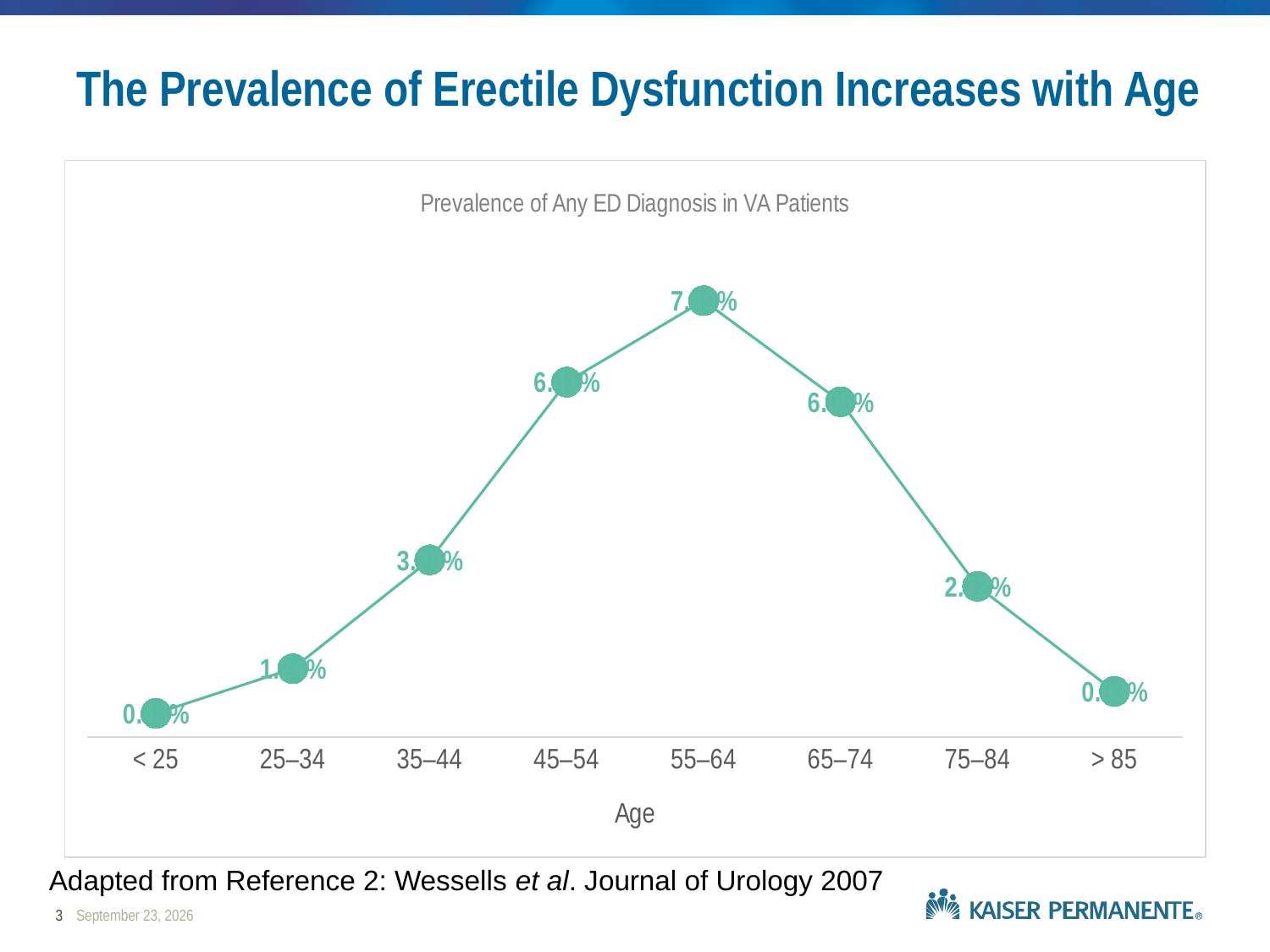
Which age group is the first category on the x axis? < 25 Is the prevalence for the 35–44 age group higher or lower than for the 75–84 age group? higher What is the label of the x axis? Age Is the prevalence for the 25–34 age group higher or lower than for the 45–54 age group? lower How does prevalence change from the < 25 group to the 55–64 group? it rises What kind of chart is shown on the slide? line chart How many age groups are plotted on the x axis? 8 Which age group has the highest prevalence of ED diagnosis? 55–64 How does prevalence change from the 55–64 group to the > 85 group? it falls Is the prevalence for the 65–74 age group higher or lower than for the > 85 age group? higher What is the title of the chart? Prevalence of Any ED Diagnosis in VA Patients